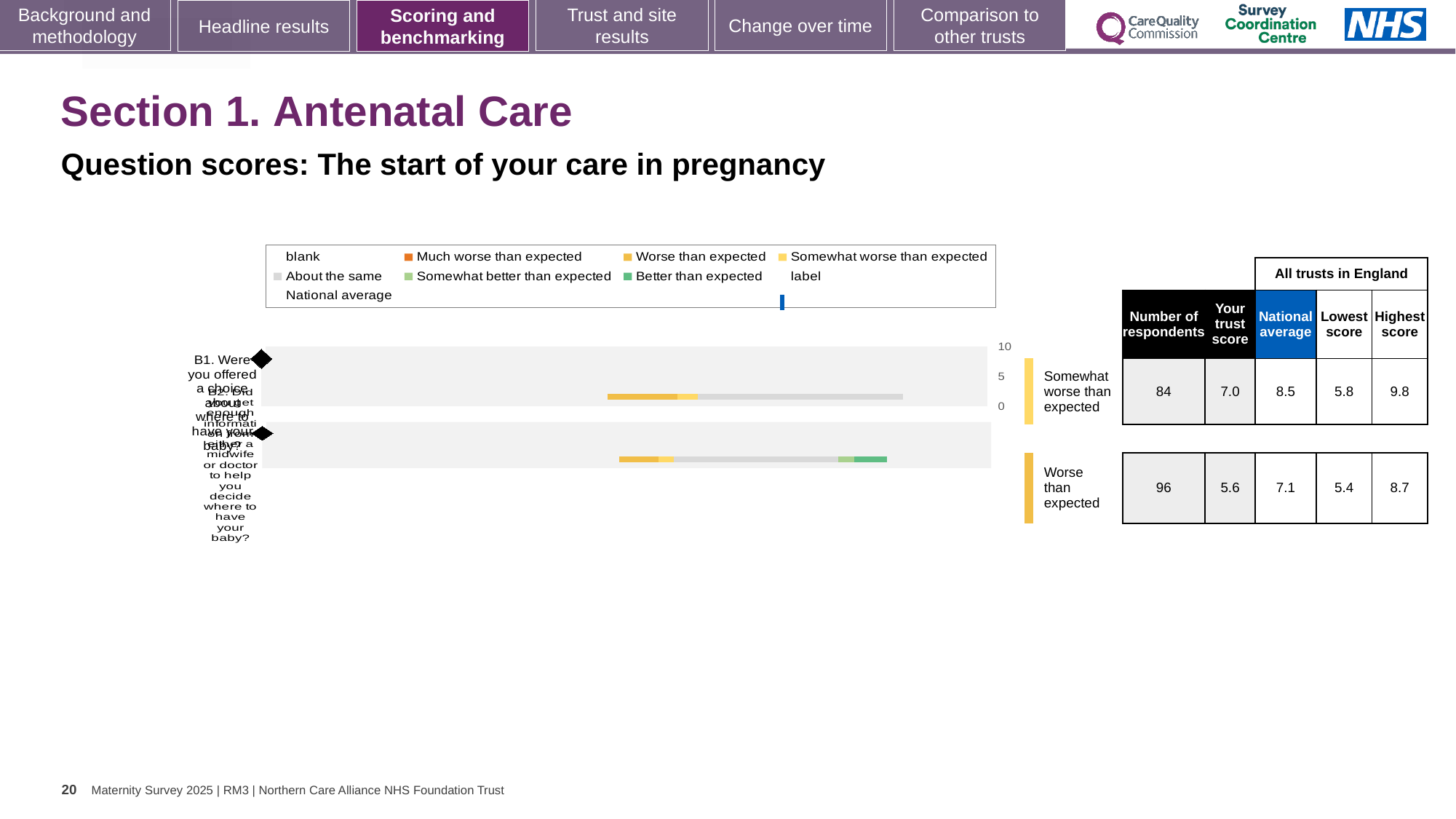
What benchmark category is shown for question B2? Worse than expected By how much is the national average higher than the trust score for question B2? 1.5 What is the 'Your trust score' for question B1 (Were you offered a choice about where to have your baby?)? 7.0 Which question has the higher trust score, B1 or B2? B1 What benchmark category is shown for question B1? Somewhat worse than expected What is the highest score among all trusts in England for question B1? 9.8 How many questions (bars) are plotted in the chart? 2 How many respondents answered question B1? 84 What is the lowest score among all trusts in England for question B2? 5.4 What kind of chart is used to show the question scores on this slide? bar chart What is the difference between the highest and lowest scores for question B2? 3.3 What is the national average score for question B2? 7.1